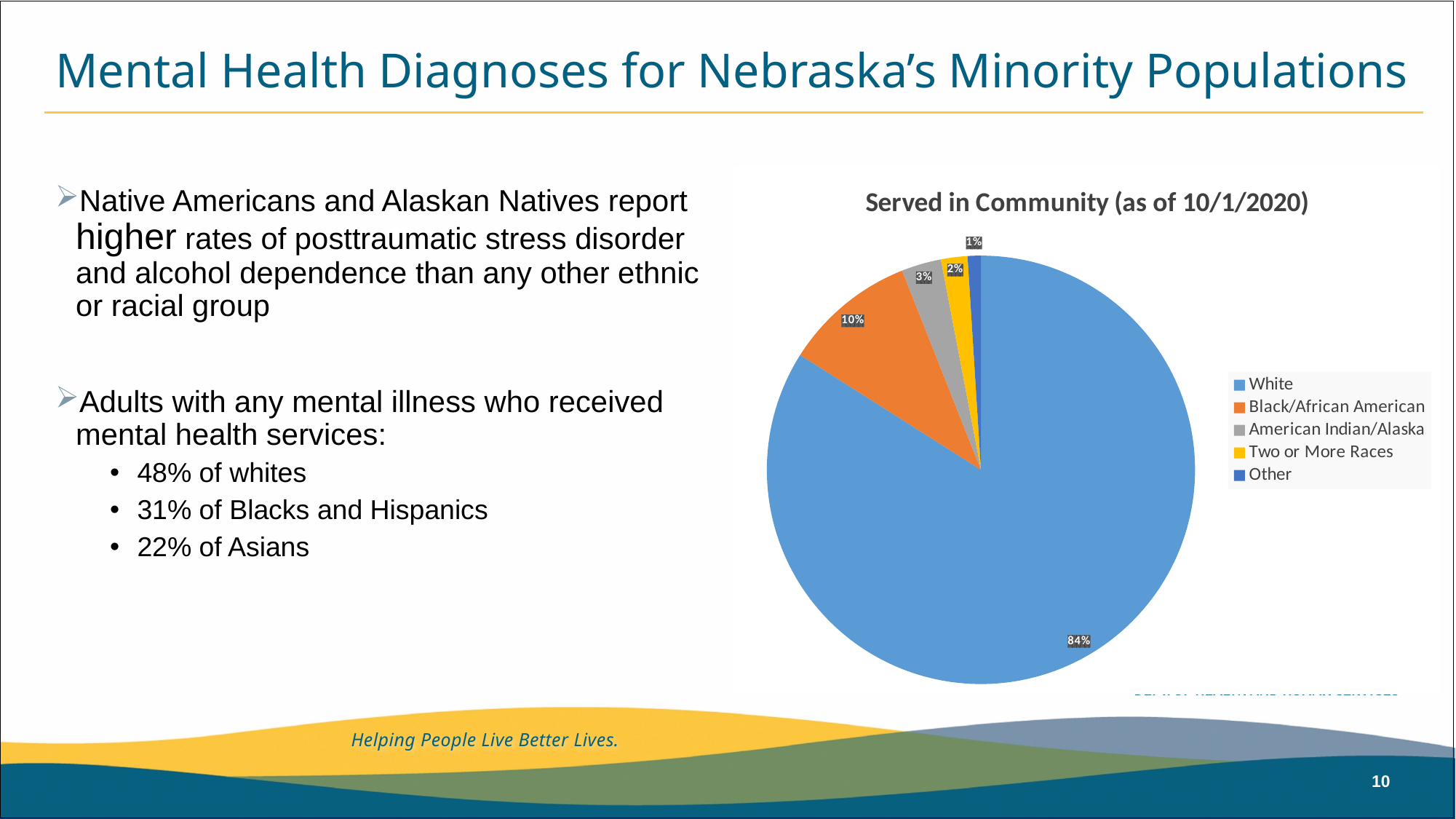
Which category has the largest slice of the pie? White What share of the pie is labelled for Other? 1% What is the difference in percentage points between the White slice and the Black/African American slice? 74 What share of the pie is labelled for White? 84% Which category has the smallest slice of the pie? Other What share of the pie is labelled for American Indian/Alaska? 3% What is the title of the chart? Served in Community (as of 10/1/2020) How many categories does the legend list? 5 What type of chart is shown on the slide? Pie chart Which slice is larger, Black/African American or American Indian/Alaska? Black/African American